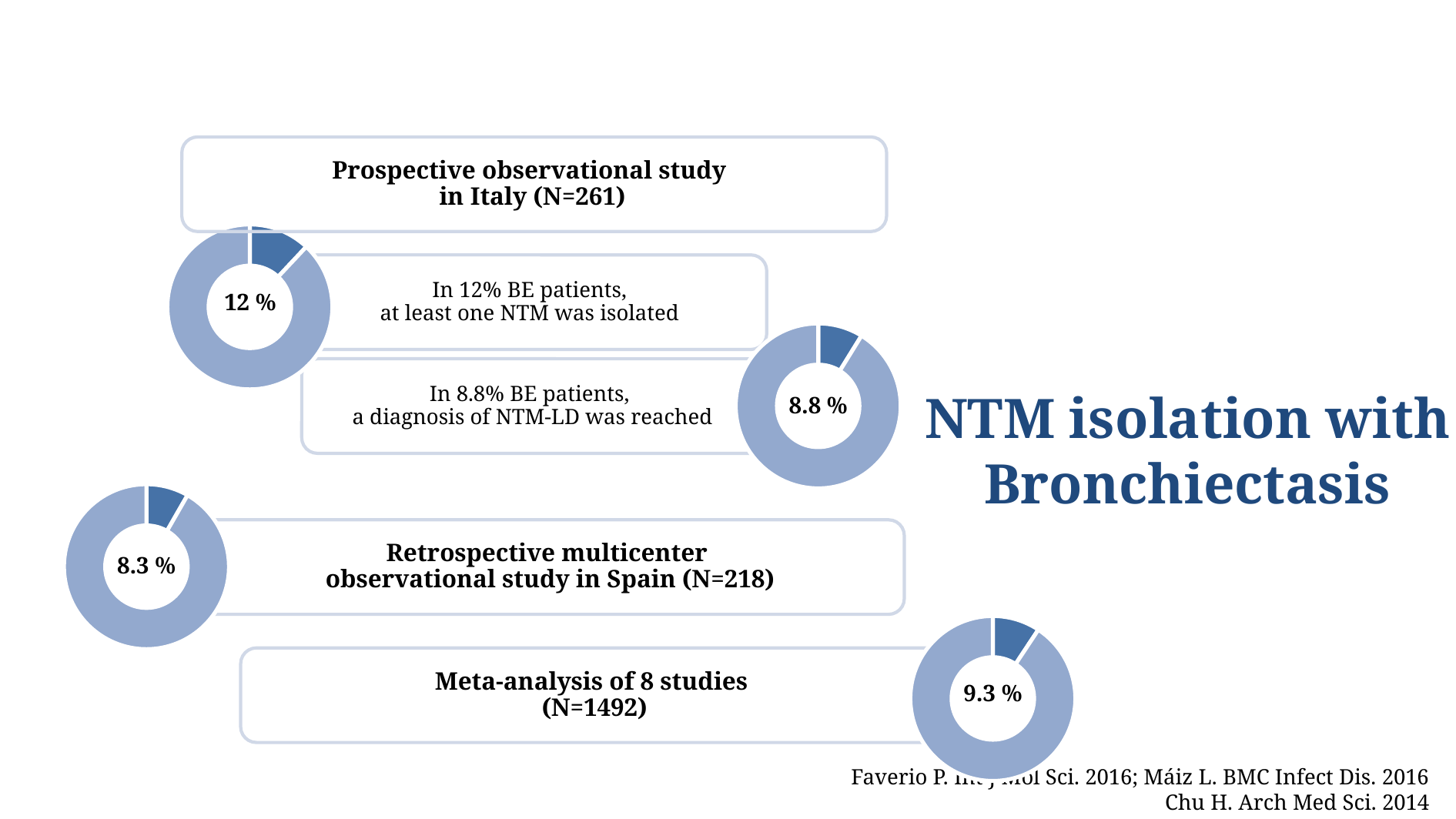
How many donut charts are shown on the slide? 4 Which donut chart shows the highest percentage? The top-left chart (Italy study), 12 % What value is shown in the donut chart next to the 'Meta-analysis of 8 studies (N=1492)' box at the bottom of the slide? 9.3 % Which is larger: the percentage in the meta-analysis donut chart or the percentage in the Spain study donut chart? The meta-analysis chart (9.3 %) What value is shown in the centre of the donut chart next to the 'Prospective observational study in Italy (N=261)' box, at the top left of the slide? 12 % What colour is the highlighted slice in each donut chart? Dark blue Which donut chart shows the lowest percentage? The chart next to the Spain study, 8.3 % What value is shown in the donut chart next to the 'Retrospective multicenter observational study in Spain (N=218)' box? 8.3 % What is the difference between the meta-analysis donut chart value and the Spain study donut chart value? 1 % What value is shown in the donut chart next to the text 'In 8.8% BE patients, a diagnosis of NTM-LD was reached'? 8.8 % What is the difference between the 12 % donut chart and the 8.8 % donut chart? 3.2 % What kind of chart is used to display the percentages on this slide? Donut (pie) chart